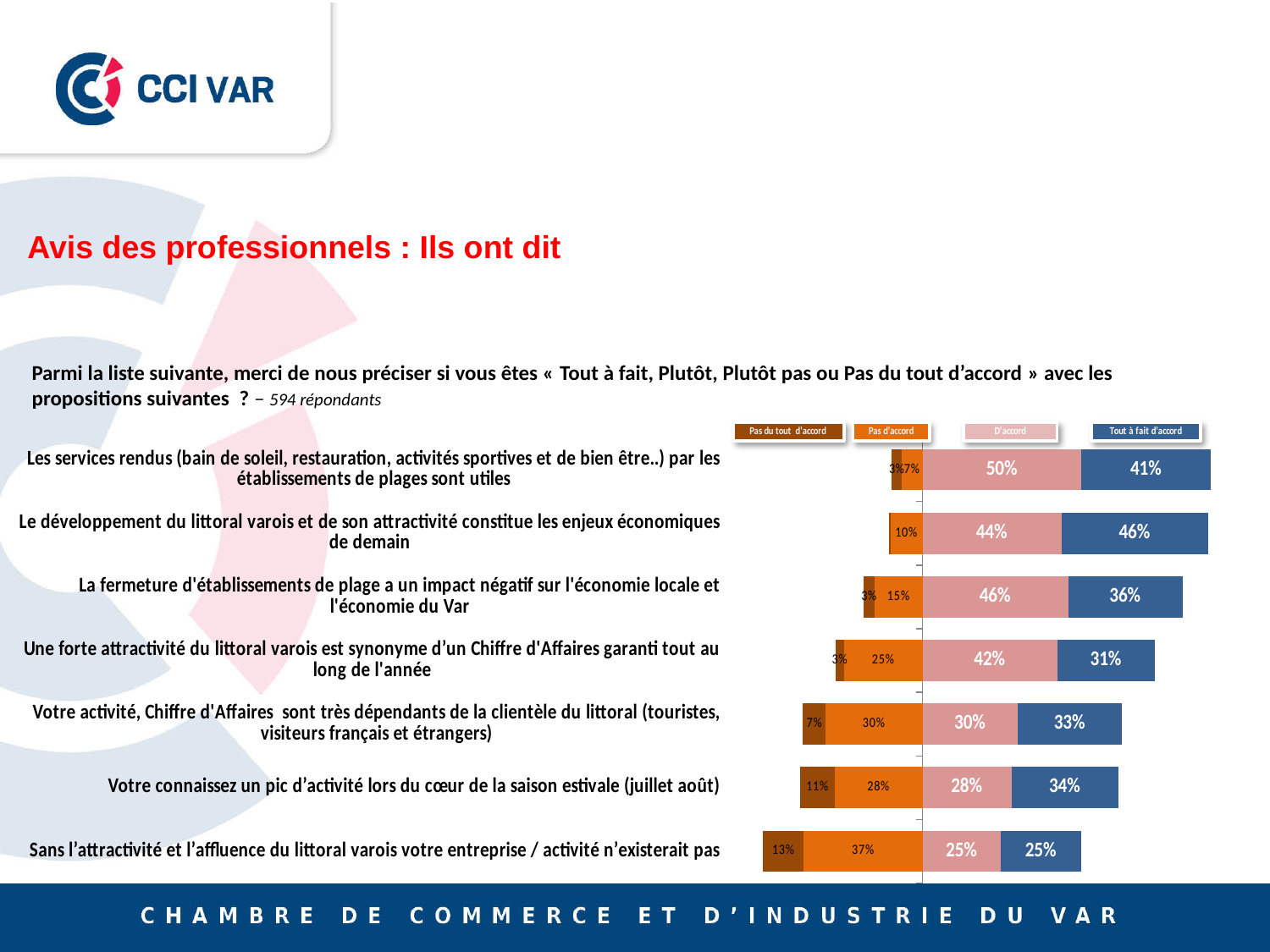
What is the 'Pas d'accord' value for 'Sans l'attractivité et l'affluence du littoral varois votre entreprise / activité n'existerait pas'? 37% Which statement has the highest 'Tout à fait d'accord' value? Le développement du littoral varois et de son attractivité constitue les enjeux économiques de demain What is the 'D'accord' value for the statement 'Les services rendus (bain de soleil, restauration, activités sportives et de bien être..) par les établissements de plages sont utiles'? 50% What is the 'Pas du tout d'accord' value for 'Votre connaissez un pic d'activité lors du cœur de la saison estivale (juillet août)'? 11% What kind of chart is shown on the slide? Stacked horizontal bar chart What is the 'Tout à fait d'accord' value for 'Le développement du littoral varois et de son attractivité constitue les enjeux économiques de demain'? 46% How many statements (categories) are plotted in the chart? 7 Which statement has the lowest 'D'accord' value? Sans l'attractivité et l'affluence du littoral varois votre entreprise / activité n'existerait pas How many series does the legend list? 4 What is the difference between the 'D'accord' value for 'Les services rendus ... par les établissements de plages sont utiles' (50%) and for 'Sans l'attractivité et l'affluence du littoral varois votre entreprise / activité n'existerait pas' (25%)? 25% What is the combined 'D'accord' and 'Tout à fait d'accord' share for 'Une forte attractivité du littoral varois est synonyme d'un Chiffre d'Affaires garanti tout au long de l'année'? 73% Which is larger: the 'Pas d'accord' value for 'Votre activité, Chiffre d'Affaires sont très dépendants de la clientèle du littoral' or for 'La fermeture d'établissements de plage a un impact négatif sur l'économie locale et l'économie du Var'? Votre activité, Chiffre d'Affaires sont très dépendants de la clientèle du littoral (30%)